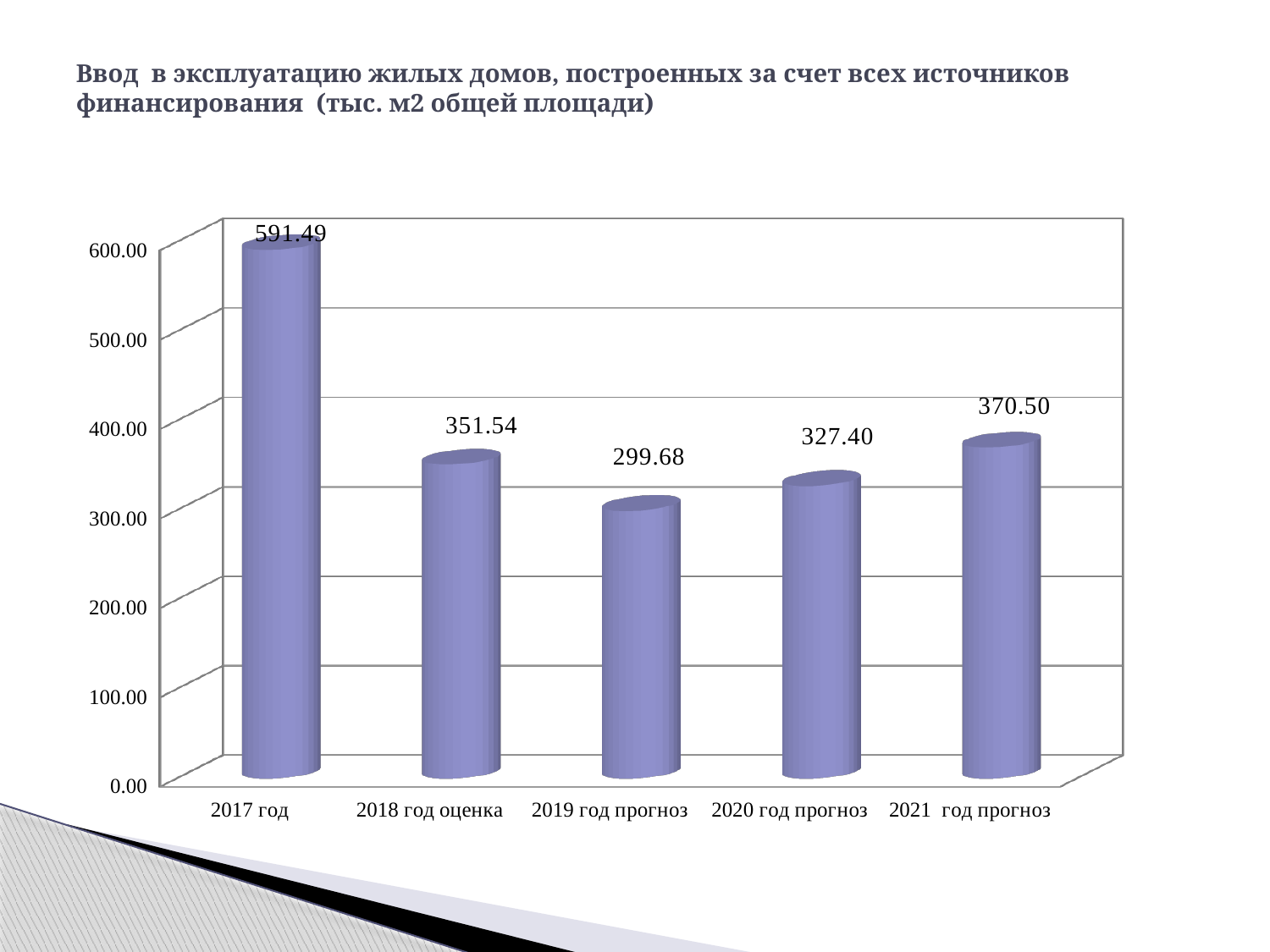
What is the value for 2019 год прогноз? 299.68 What is the value for 2017 год? 591.49 How many categories are shown on the x axis? 5 What is the value for 2021 год прогноз? 370.50 What is the difference between the values for 2017 год and 2018 год оценка? 239.95 What is the value for 2020 год прогноз? 327.40 Which is larger, the value for 2018 год оценка or the value for 2020 год прогноз? 2018 год оценка Is the value for 2021 год прогноз greater or less than 400.00? less Which category has the highest value? 2017 год Which category has the lowest value? 2019 год прогноз What is the difference between the values for 2021 год прогноз and 2020 год прогноз? 43.10 What kind of chart is shown on the slide? bar chart